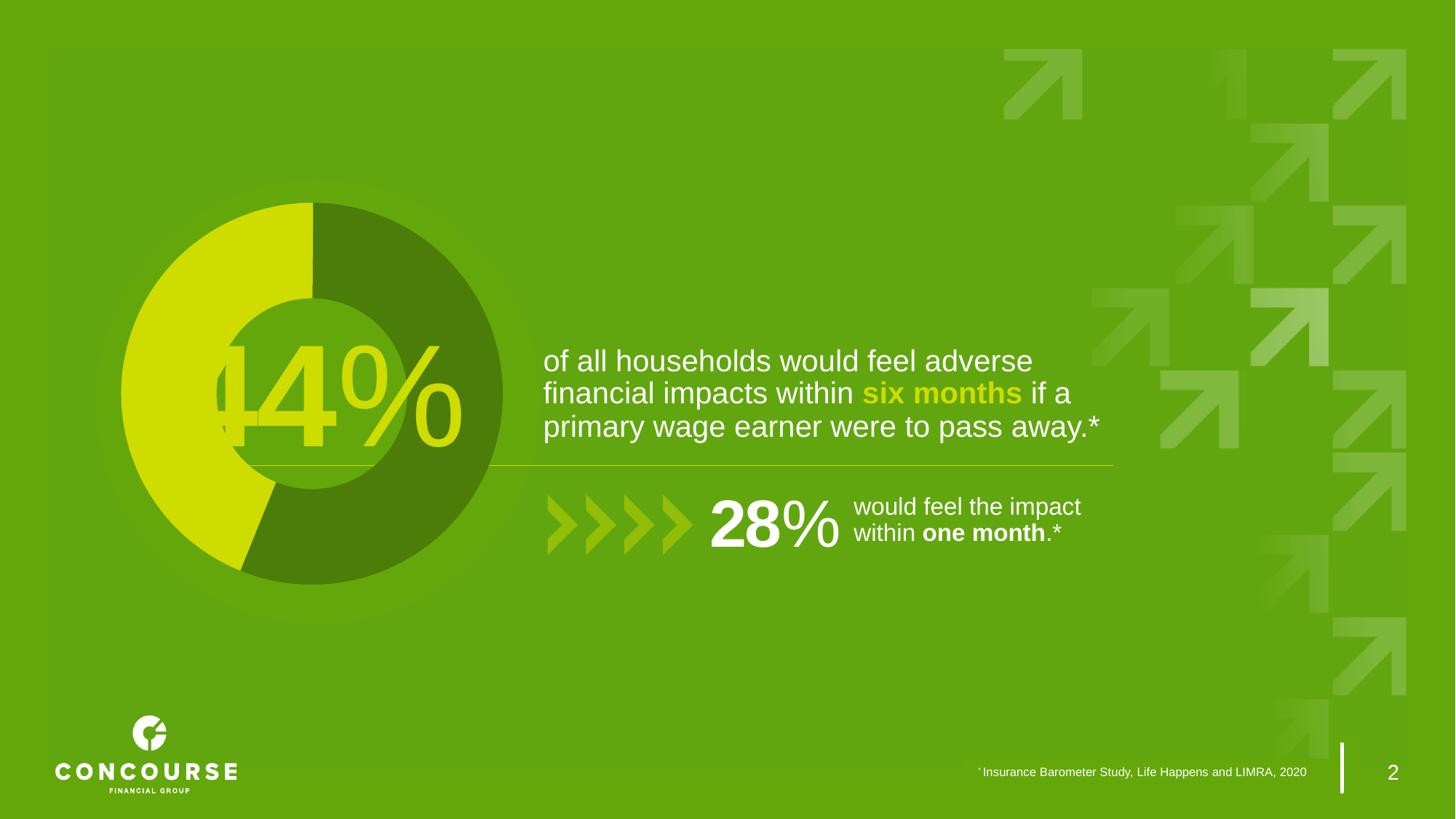
What is the difference between the share of households affected within six months and the share affected within one month? 16% Is the highlighted slice of the donut chart greater or less than 50% of the whole? less According to the slide, what percentage of households would feel the impact within one month? 28% What source is cited for the statistics on the slide? Insurance Barometer Study, Life Happens and LIMRA, 2020 According to the slide, what percentage of households would feel adverse financial impacts within six months if a primary wage earner were to pass away? 44% What kind of chart is shown on the slide? Donut (pie) chart What share of the donut chart is not highlighted (the dark green portion)? 56% What percentage does the highlighted slice of the donut chart represent? 44% What colour is the slice representing 44% in the donut chart? Bright yellow-green Which slice of the donut chart is larger, the bright yellow-green slice or the dark green slice? The dark green slice How many slices does the donut chart have? 2